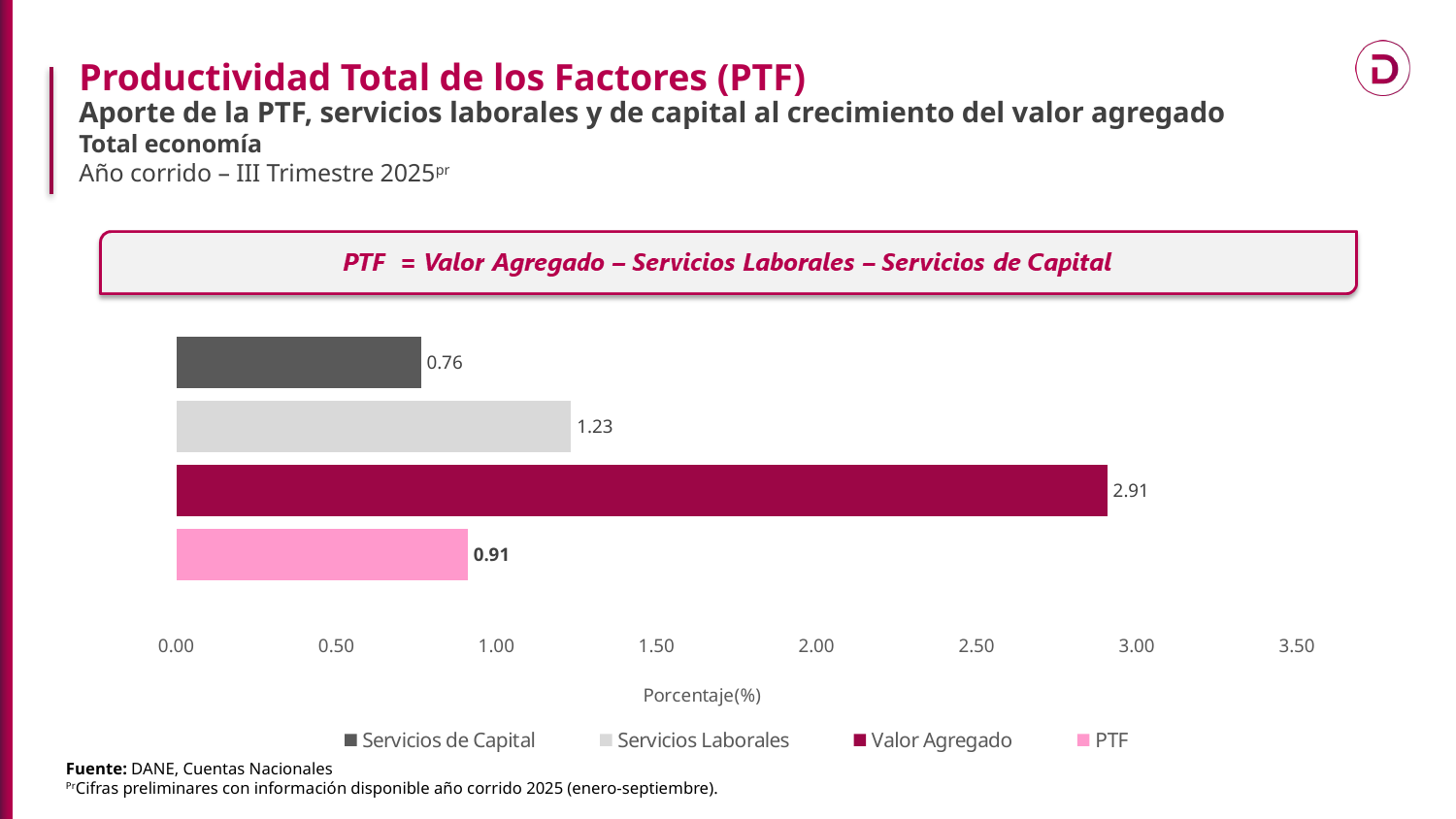
How many series does the legend list? 4 What is the difference between Valor Agregado and Servicios Laborales? 1.68 Which is larger, PTF or Servicios de Capital? PTF Is the value for Servicios Laborales greater or less than 1.00? greater What kind of chart is shown on the slide? Bar chart What is the value for Servicios Laborales? 1.23 Which series has the lowest value? Servicios de Capital What is the value for Valor Agregado? 2.91 What is the value for Servicios de Capital? 0.76 What is the label of the horizontal axis? Porcentaje(%) What is the value for PTF? 0.91 Which series has the highest value? Valor Agregado